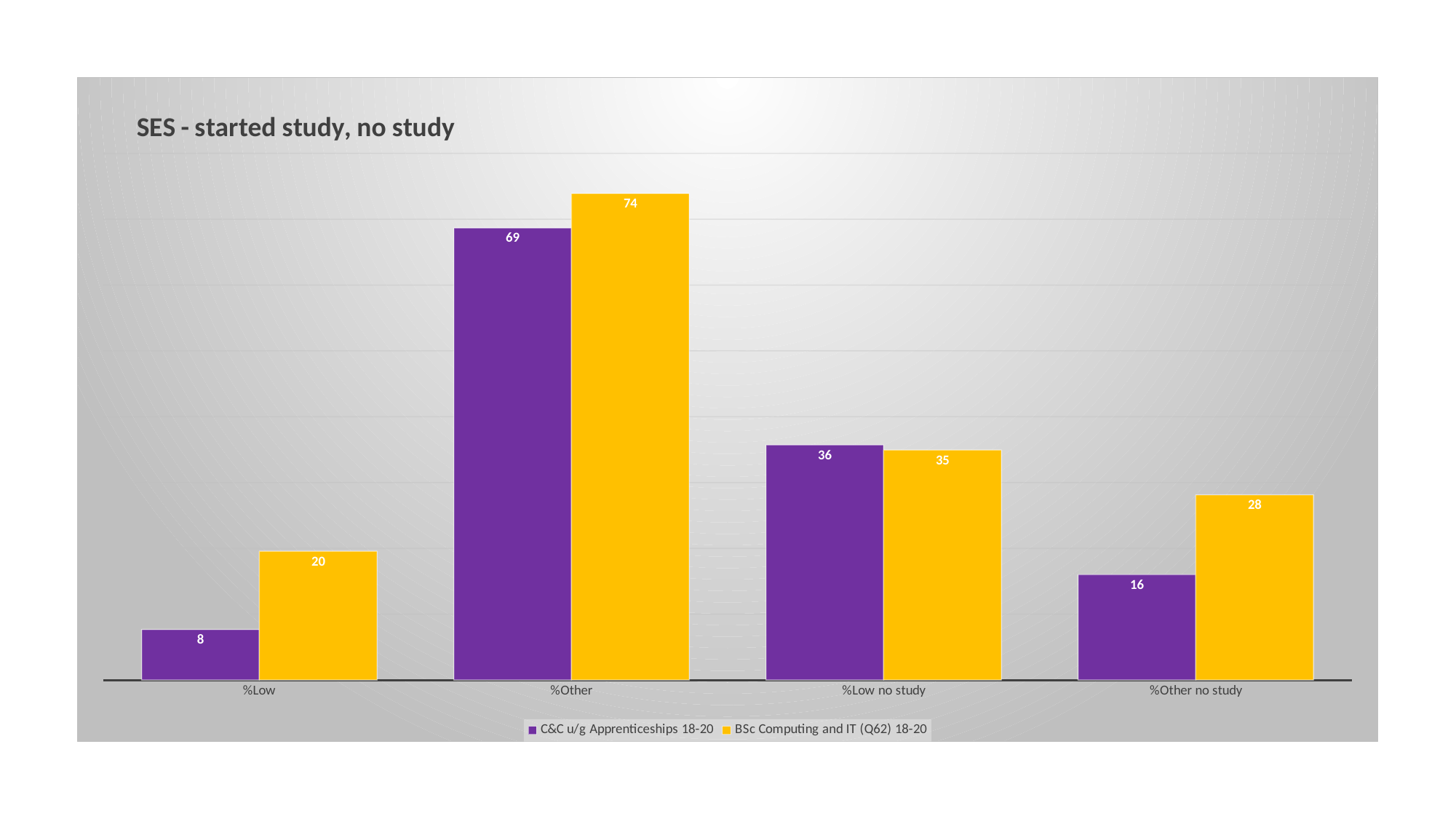
What is the value for C&C u/g Apprenticeships 18-20 in the %Low no study category? 36 In the %Other no study category, which series has the larger value? BSc Computing and IT (Q62) 18-20 What is the difference between the BSc Computing and IT (Q62) 18-20 value and the C&C u/g Apprenticeships 18-20 value in the %Low category? 12 What is the value for BSc Computing and IT (Q62) 18-20 in the %Other category? 74 How many categories are shown on the x axis? 4 What kind of chart is shown on the slide? Bar chart What is the value for BSc Computing and IT (Q62) 18-20 in the %Other no study category? 28 What is the value for C&C u/g Apprenticeships 18-20 in the %Low category? 8 Which category has the lowest value for BSc Computing and IT (Q62) 18-20? %Low What is the title of the chart? SES - started study, no study How many series does the legend list? 2 Which category has the highest value for C&C u/g Apprenticeships 18-20? %Other